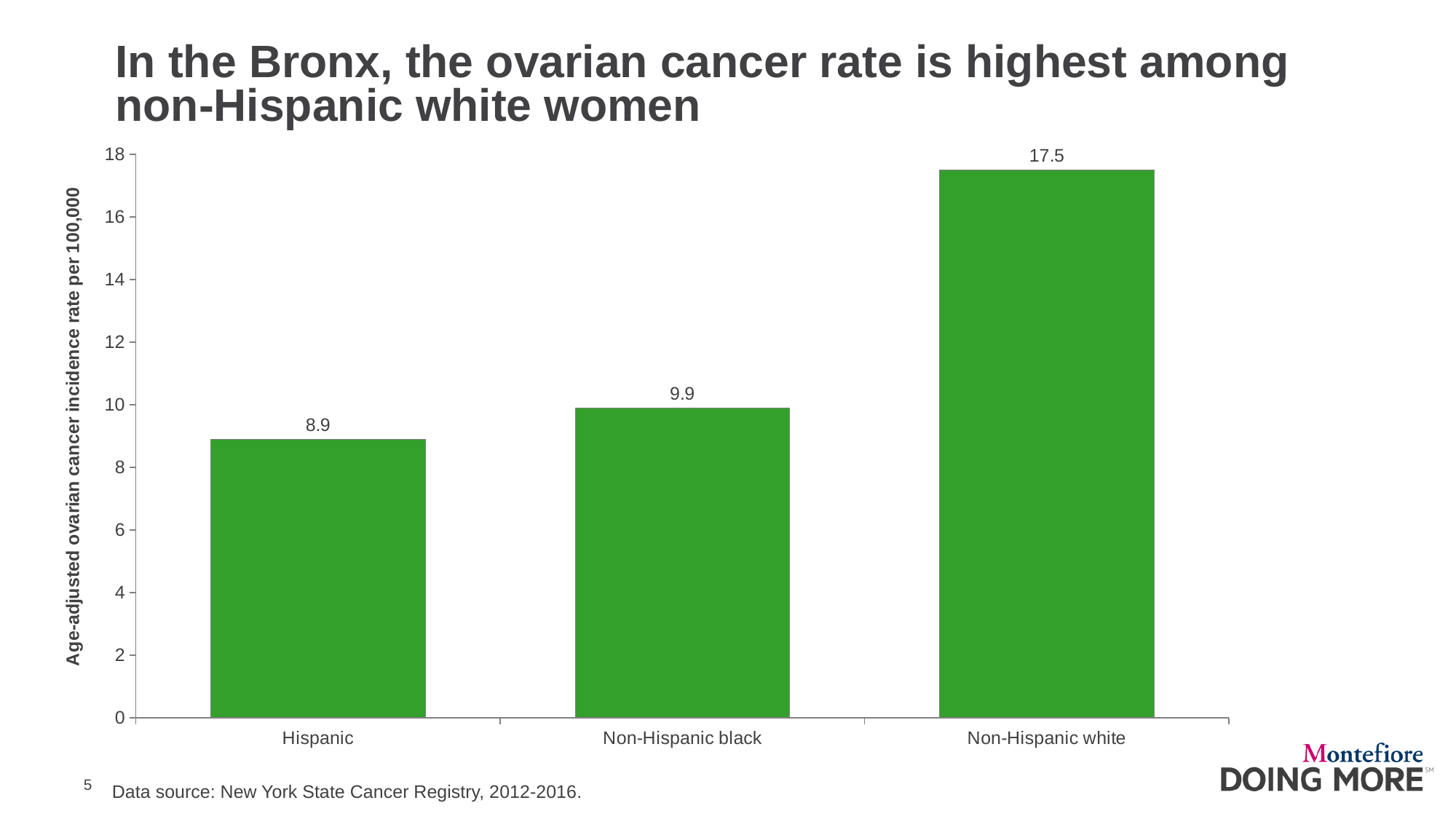
What is the label of the y axis? Age-adjusted ovarian cancer incidence rate per 100,000 What is the difference between the incidence rates for Non-Hispanic white and Hispanic women? 8.6 What kind of chart is shown on the slide? Bar chart What is the age-adjusted ovarian cancer incidence rate per 100,000 for Non-Hispanic black women? 9.9 Is the value for Non-Hispanic white greater or less than 16? greater Which group has the lowest ovarian cancer incidence rate? Hispanic How many groups are shown on the x axis? 3 What is the age-adjusted ovarian cancer incidence rate per 100,000 for Non-Hispanic white women? 17.5 Which is larger, the incidence rate for Non-Hispanic black women or for Hispanic women? Non-Hispanic black What is the difference between the incidence rates for Non-Hispanic black and Hispanic women? 1.0 What is the age-adjusted ovarian cancer incidence rate per 100,000 for Hispanic women? 8.9 Which group has the highest ovarian cancer incidence rate? Non-Hispanic white